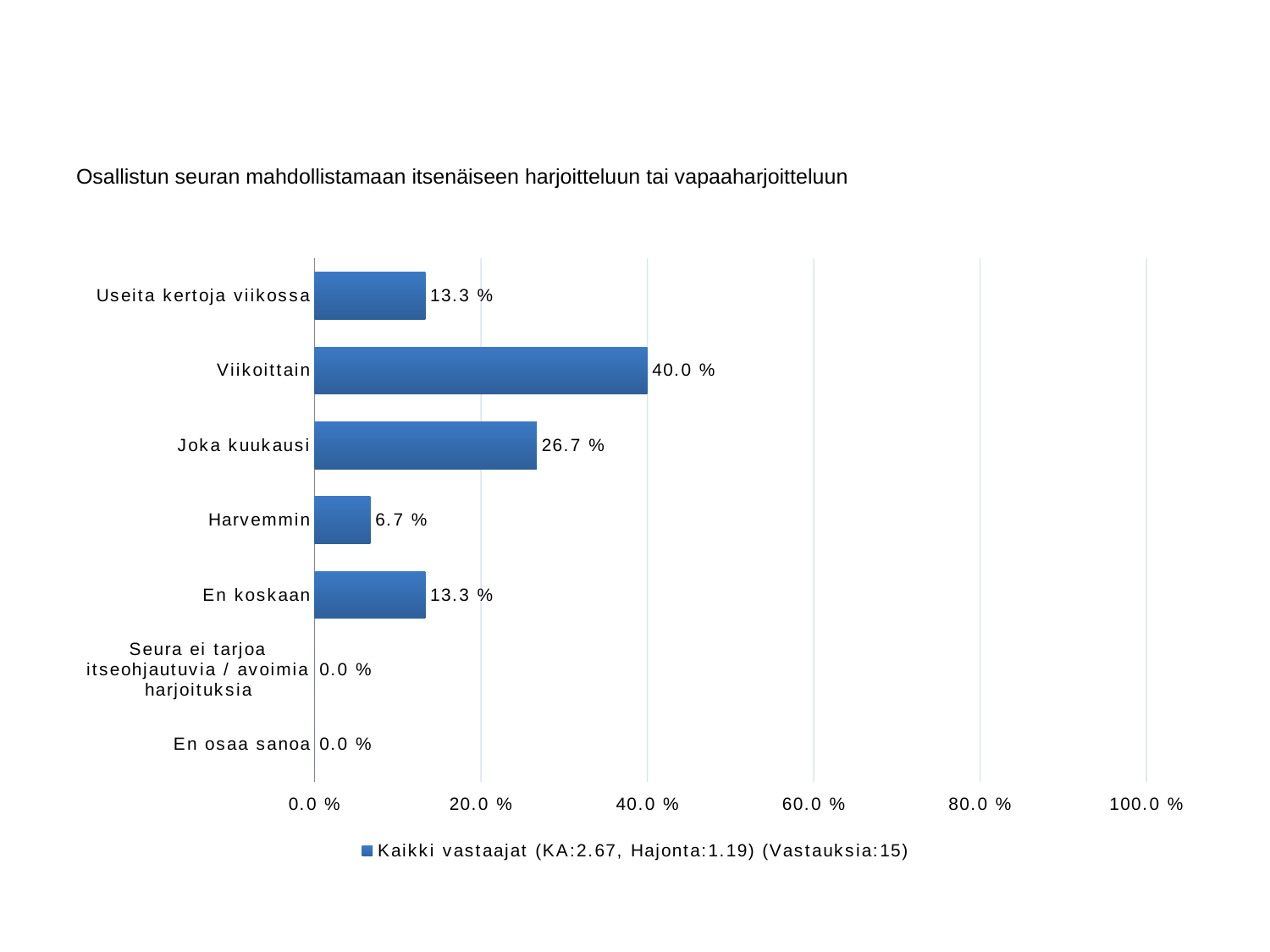
What is the value for Harvemmin? 6.7 % How many categories are shown on the chart? 7 What is the difference between the values for Useita kertoja viikossa and Harvemmin? 6.6 % Is the value for Viikoittain greater or less than 20.0 %? greater What is the value for En osaa sanoa? 0.0 % What is the value for Joka kuukausi? 26.7 % What is the difference between the values for Viikoittain and Joka kuukausi? 13.3 % Which category has the highest value? Viikoittain How many series does the legend list? 1 What kind of chart is shown on the slide? Bar chart Which is larger, the value for Joka kuukausi or the value for En koskaan? Joka kuukausi What is the value for Viikoittain? 40.0 %